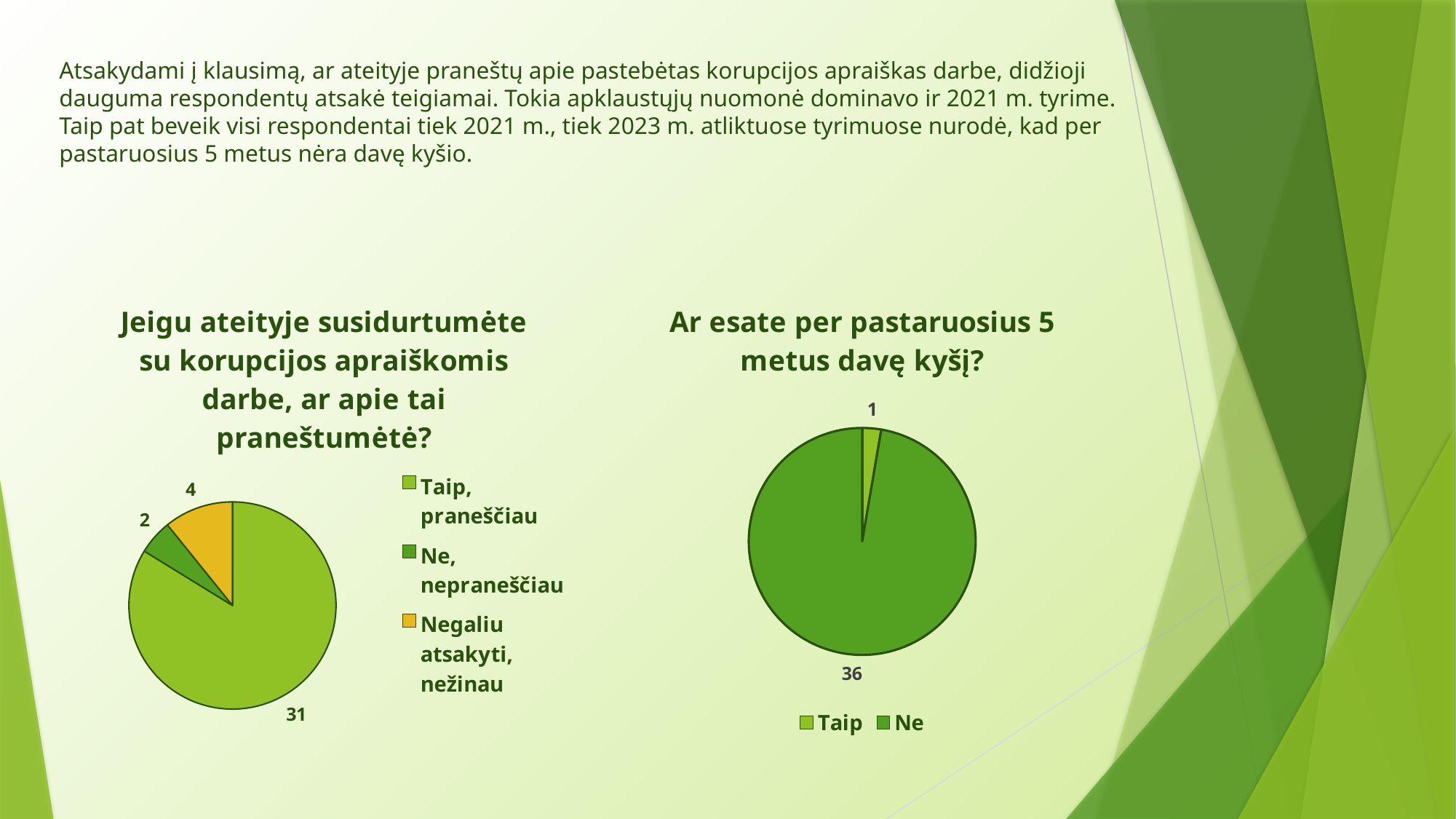
In the left chart, how many categories does the legend list? 3 In the left chart, what is the difference between "Taip, praneščiau" and "Negaliu atsakyti, nežinau"? 27 In the left chart, which category has the smallest slice? Ne, nepraneščiau In the left chart, which category has the largest slice? Taip, praneščiau In the left chart, what is the value for "Ne, nepraneščiau"? 2 In the right chart, what is the difference between "Ne" and "Taip"? 35 In the left chart, what is the value for "Negaliu atsakyti, nežinau"? 4 In the right chart, which is larger, "Taip" or "Ne"? Ne What type of chart is the right chart? Pie chart In the right chart, what is the value for "Taip"? 1 In the left chart ("Jeigu ateityje susidurtumėte su korupcijos apraiškomis darbe, ar apie tai praneštumėte?"), what is the value for "Taip, praneščiau"? 31 In the right chart ("Ar esate per pastaruosius 5 metus davę kyšį?"), what is the value for "Ne"? 36